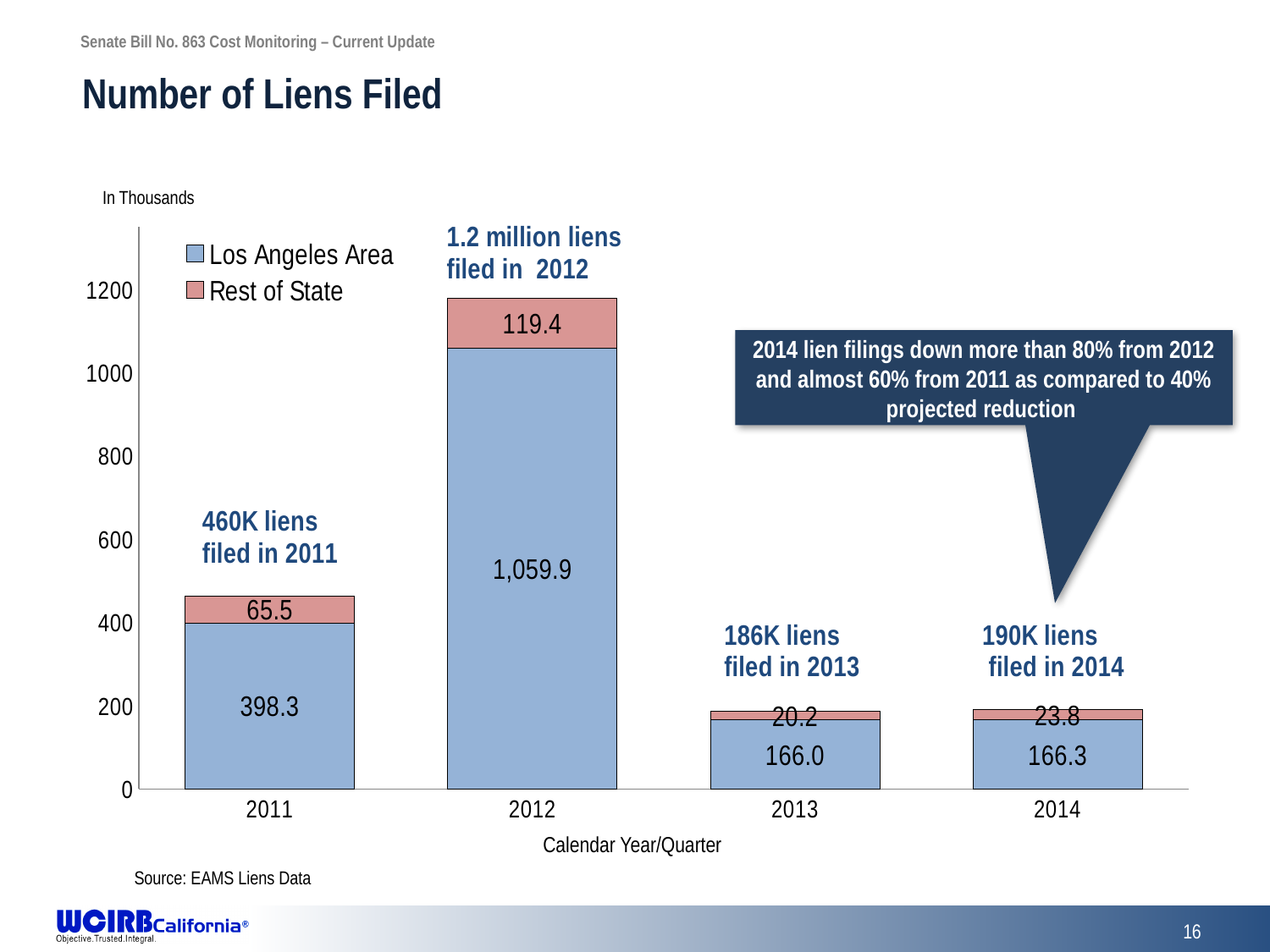
What is the Rest of State value for 2011? 65.5 Which year has the highest Rest of State value? 2012 How many series does the legend list? 2 Which is larger, the Rest of State value for 2013 or for 2014? 2014 What is the x-axis title of the chart? Calendar Year/Quarter Which year has the lowest Los Angeles Area value? 2013 How many years are shown on the x axis? 4 What is the Los Angeles Area value for 2014? 166.3 What is the total of the stacked bar for 2013? 186.2 What kind of chart is shown on the slide? Stacked bar chart What is the difference between the Los Angeles Area values for 2012 and 2011? 661.6 What is the Los Angeles Area value for 2012? 1,059.9